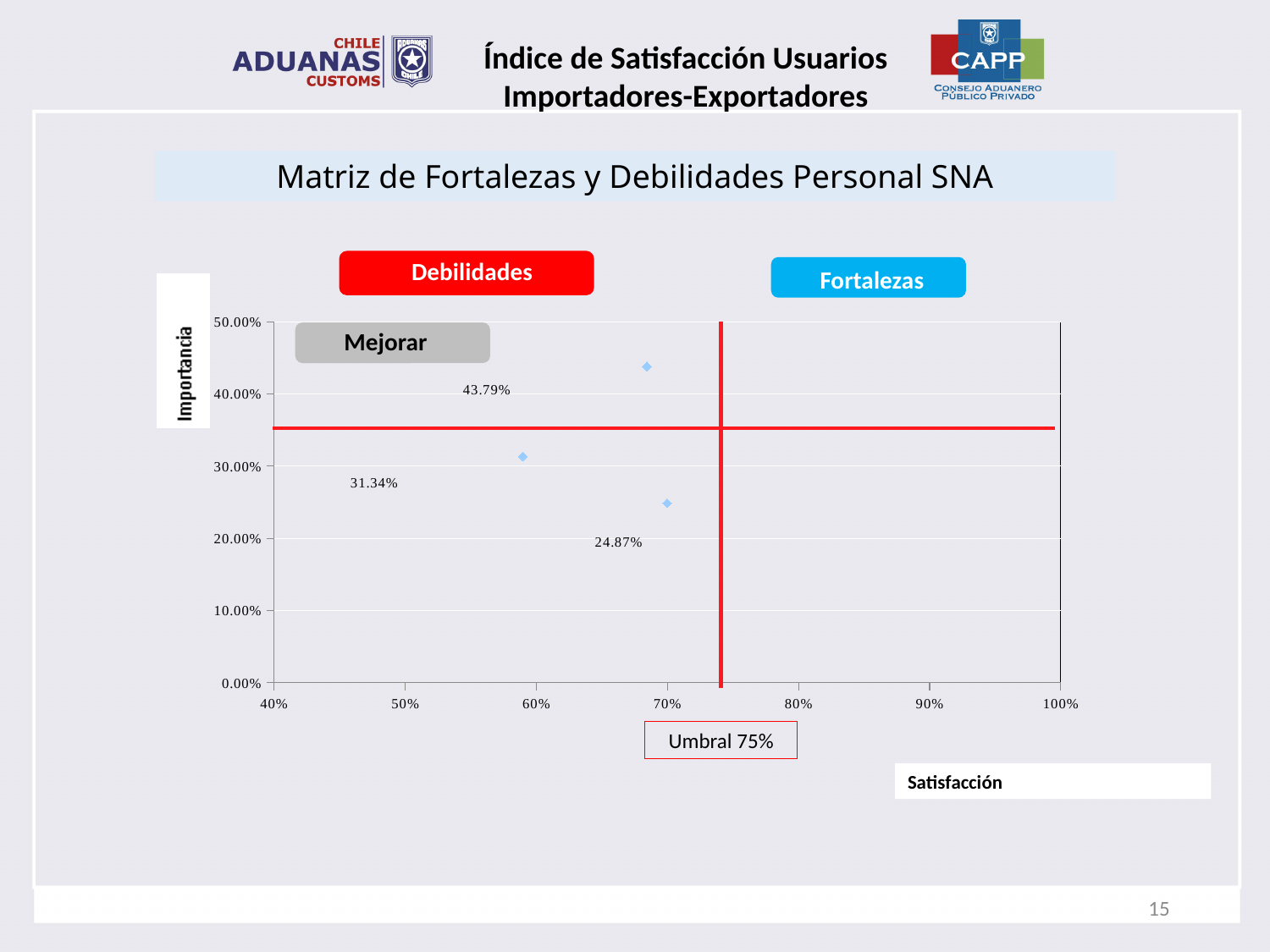
Is the Satisfacción value of the point labeled 31.34% greater or less than 50%? greater What is the title of the chart? Matriz de Fortalezas y Debilidades Personal SNA What is the difference between the highest and lowest labeled Importancia values? 18.92% What is the lowest Importancia value labeled on the chart? 24.87% Which labeled point has the larger Importancia value, the one labeled 31.34% or the one labeled 24.87%? 31.34% What is the difference between the labeled values 43.79% and 31.34%? 12.45% What is the highest Importancia value labeled on the chart? 43.79% How many data points are plotted in the chart? 3 Is the Satisfacción value of the point labeled 24.87% greater or less than 80%? less Is the Satisfacción value of the point labeled 43.79% greater or less than 75%? less What threshold (Umbral) value is marked by the vertical red line on the chart? 75% What kind of chart is shown on the slide? scatter chart